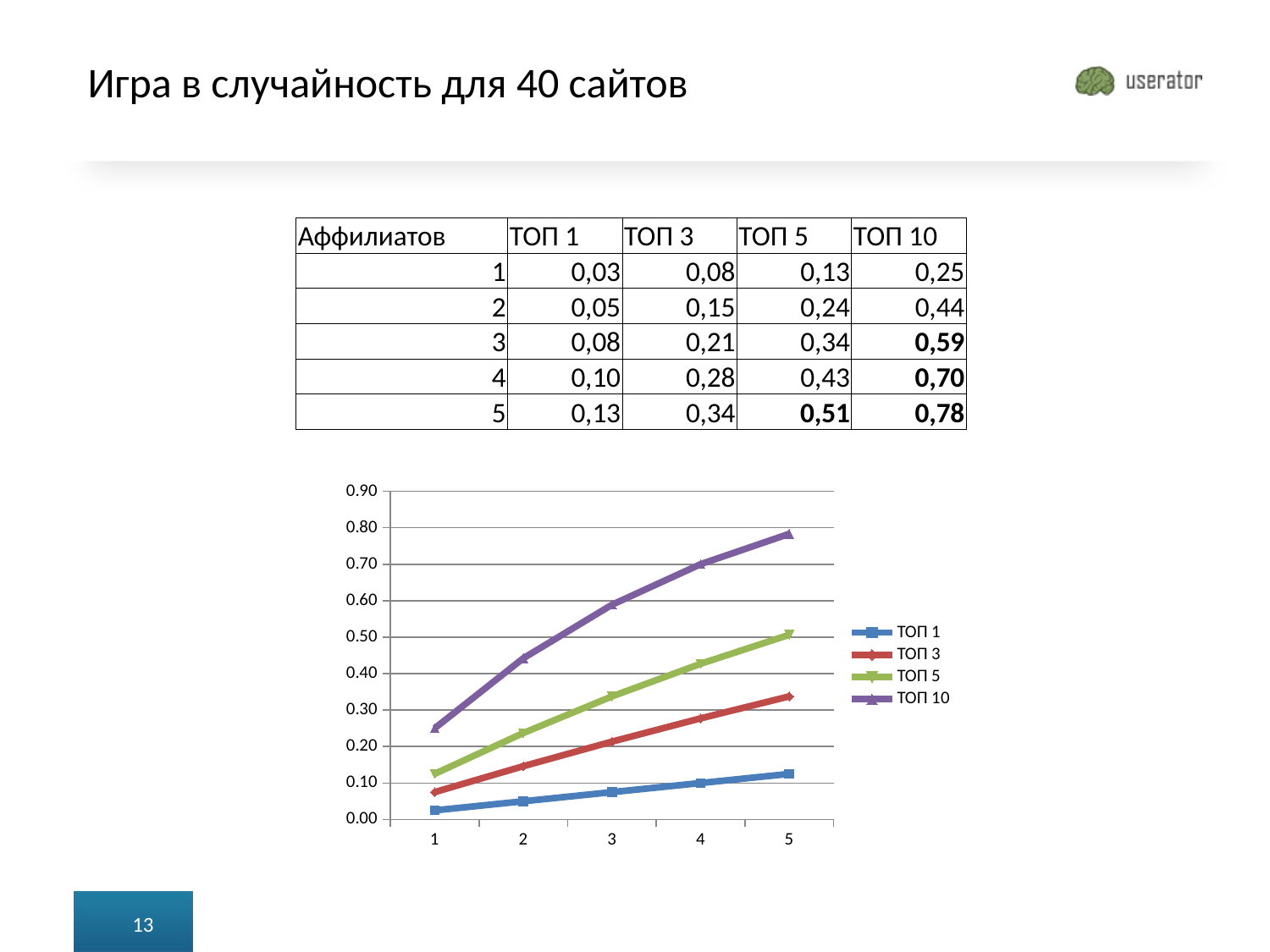
Is the value of ТОП 5 at x = 3 greater or less than 0.30? greater How many points are plotted along the x axis for each series? 5 How many series does the chart legend list? 4 What kind of chart is shown on the slide? line chart Which series has the lowest value at x = 1? ТОП 1 Which is larger at x = 4: the value of ТОП 3 or the value of ТОП 5? ТОП 5 Which series has the highest value at x = 5? ТОП 10 Is the value of ТОП 10 at x = 5 greater or less than 0.70? greater Is the value of ТОП 1 at x = 5 greater or less than 0.20? less According to the table on the slide, what is the value of ТОП 10 for 5 affiliates? 0,78 According to the table on the slide, what is the difference between ТОП 5 and ТОП 1 for 5 affiliates? 0,38 Do the values of the ТОП 10 series rise or fall as x increases from 1 to 5? rise